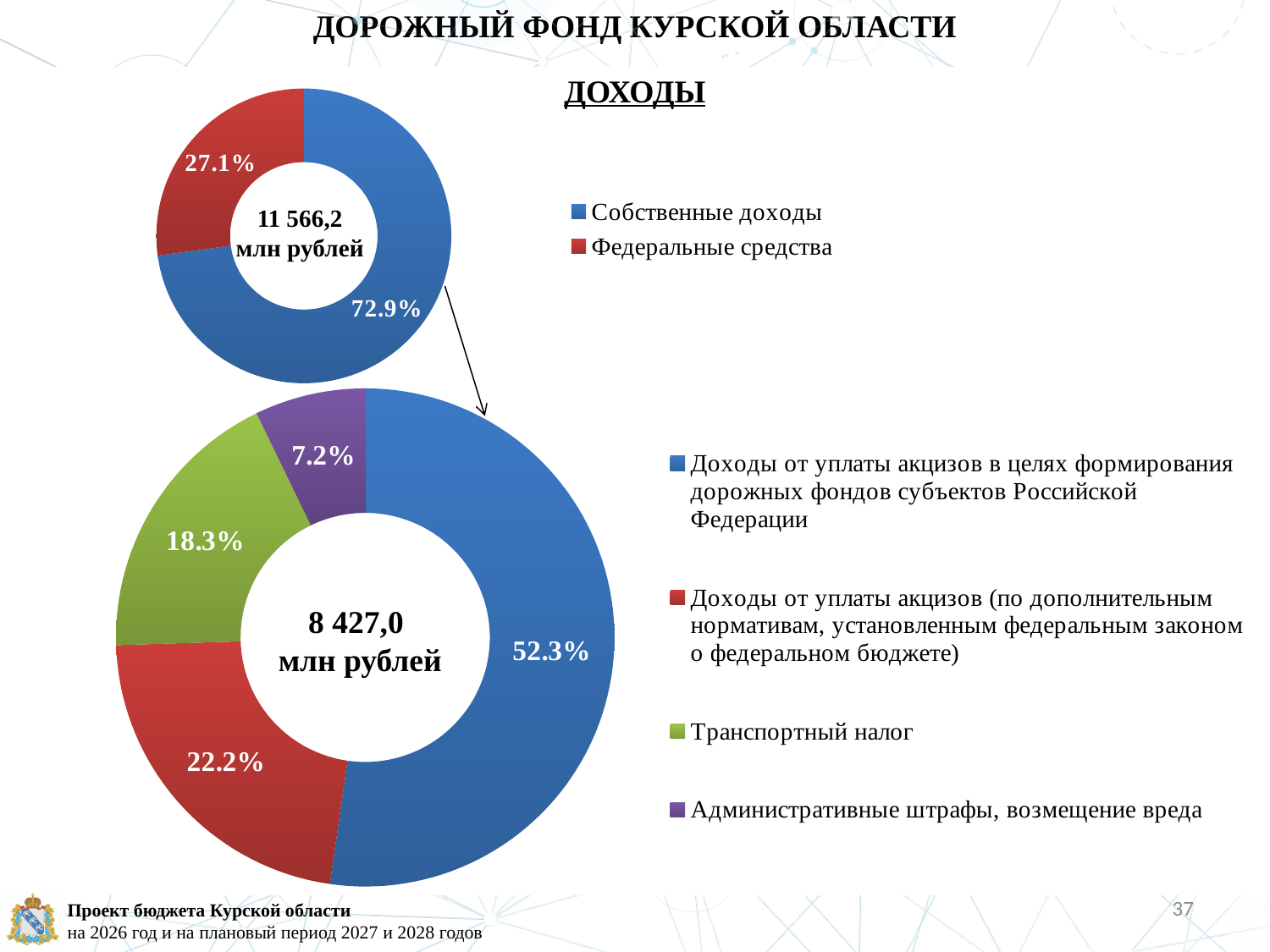
What total amount is printed in the centre of the upper doughnut chart? 11 566,2 млн рублей In the upper doughnut chart, what share is labelled for Федеральные средства? 27.1% What type of chart is the lower chart on the slide? Doughnut (pie) chart In the lower doughnut chart, which category has the smallest share? Административные штрафы, возмещение вреда What total amount is printed in the centre of the lower doughnut chart? 8 427,0 млн рублей How many series does the legend of the upper doughnut chart list? 2 In the lower doughnut chart, what is the difference in percentage points between the share for Транспортный налог and the share for Административные штрафы, возмещение вреда? 11.1 In the lower doughnut chart, which category has the largest share? Доходы от уплаты акцизов в целях формирования дорожных фондов субъектов Российской Федерации In the lower doughnut chart, what share is labelled for Доходы от уплаты акцизов (по дополнительным нормативам, установленным федеральным законом о федеральном бюджете)? 22.2% In the lower doughnut chart, what share is labelled for Административные штрафы, возмещение вреда? 7.2%